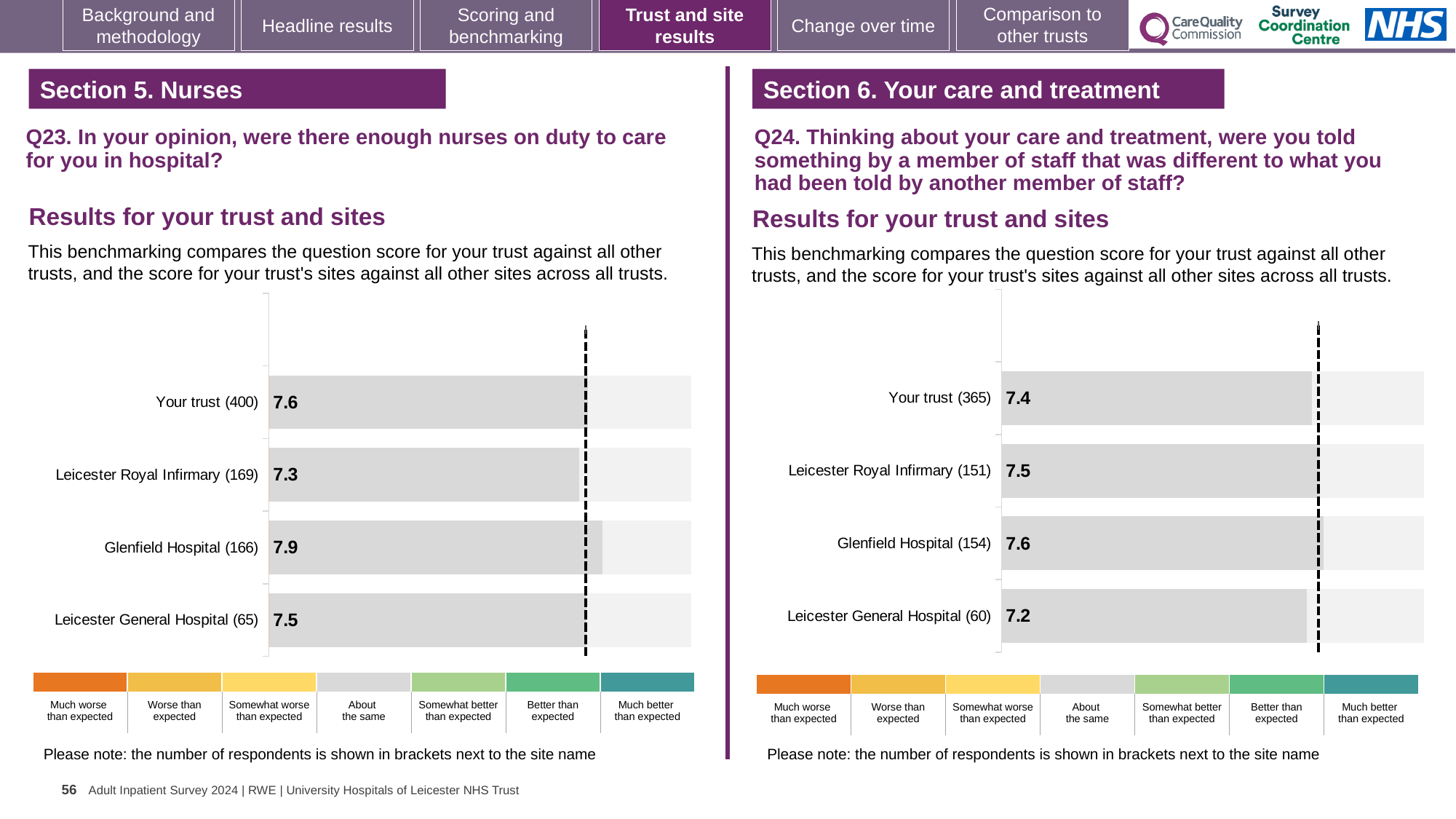
What type of chart is used for the Q23 results on the left? Bar chart In the Q23 chart (left), what is the score for Your trust? 7.6 In the Q24 chart (right), which is larger, the score for Your trust or the score for Leicester General Hospital? Your trust In the Q24 chart (right), what is the score for Leicester Royal Infirmary? 7.5 In the Q23 chart (left), which site or trust has the highest score? Glenfield Hospital In the Q24 chart (right), what is the score for Leicester General Hospital? 7.2 In the Q23 chart (left), what is the score for Glenfield Hospital? 7.9 In the Q23 chart (left), what is the difference between the scores for Glenfield Hospital and Leicester Royal Infirmary? 0.6 In the Q24 chart (right), what is the difference between the scores for Glenfield Hospital and Leicester General Hospital? 0.4 In the Q24 chart (right), which site or trust has the highest score? Glenfield Hospital In the Q23 chart (left), how many bars are plotted? 4 In the Q23 chart (left), which site or trust has the lowest score? Leicester Royal Infirmary